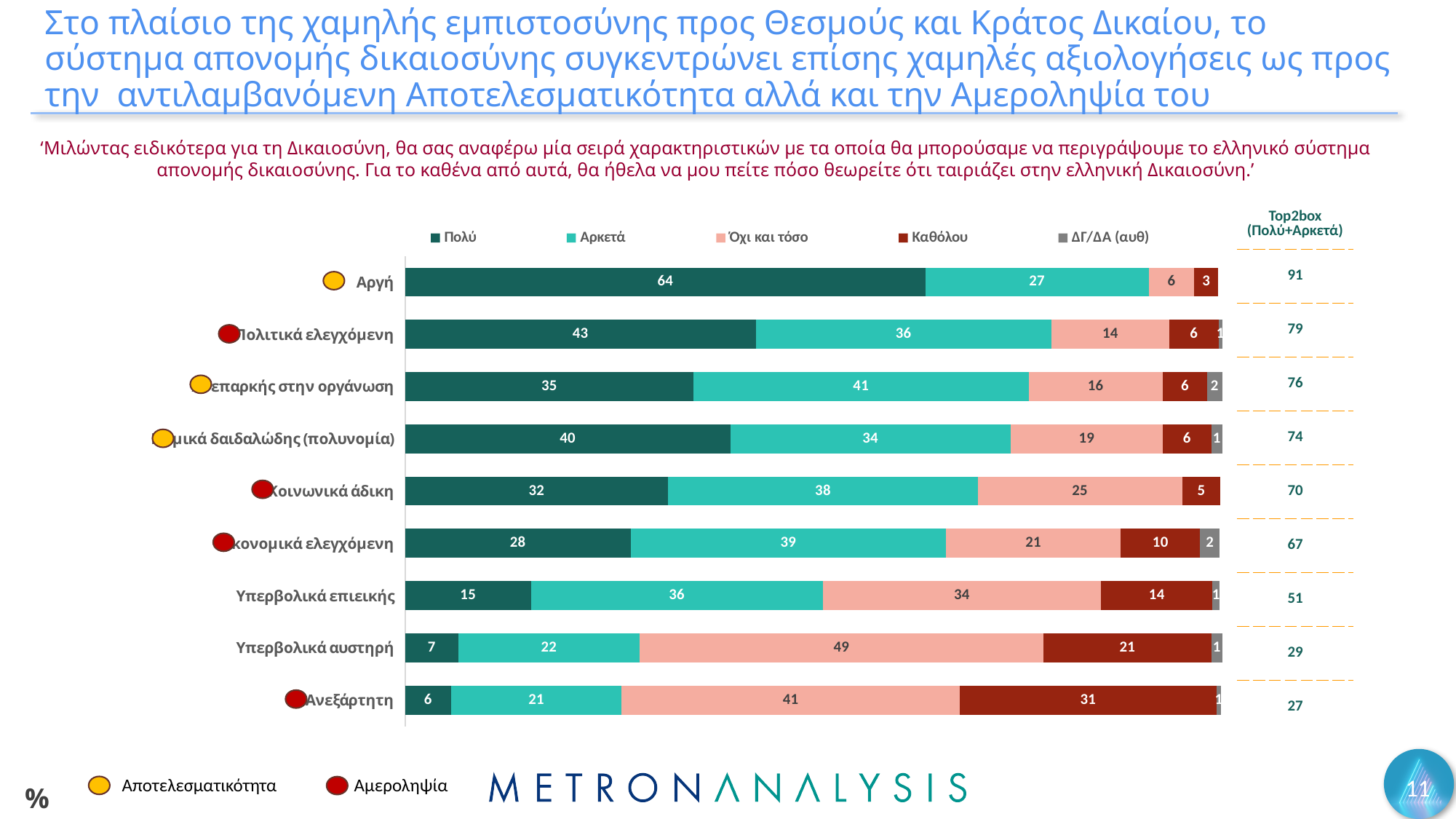
What is the value of the 'Πολύ' series for 'Αργή'? 64 What is the value of the 'Καθόλου' series for 'Υπερβολικά αυστηρή'? 21 What kind of chart is shown on the slide? Stacked bar chart How many categories (bars) are shown in the chart? 9 What is the value of the 'Αρκετά' series for 'Ανεξάρτητη'? 21 Which has the larger 'Όχι και τόσο' value: 'Υπερβολικά αυστηρή' or 'Ανεξάρτητη'? Υπερβολικά αυστηρή How many series does the legend list? 5 What is the combined total of the 'Πολύ' and 'Αρκετά' segments for 'Αργή'? 91 Which category has the lowest value in the 'Πολύ' series? Ανεξάρτητη What is the Top2box (Πολύ+Αρκετά) value shown for 'Υπερβολικά επιεικής'? 51 Which category has the highest value in the 'Πολύ' series? Αργή What is the difference between the 'Πολύ' values for 'Αργή' and 'Πολιτικά ελεγχόμενη'? 21